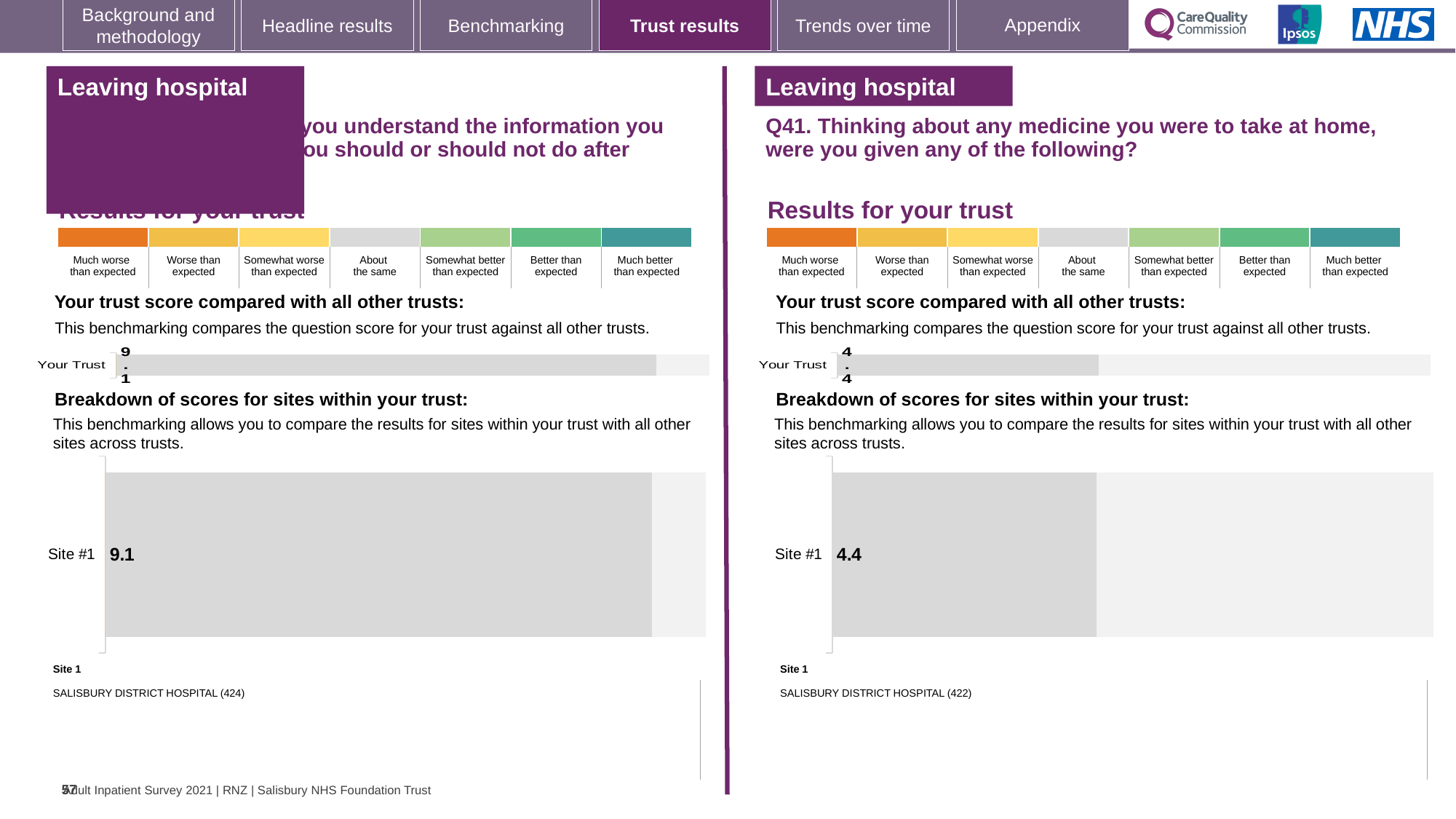
On the right half of the slide (Q41), what is the score shown for Your Trust in the 'Your trust score compared with all other trusts' chart? 4.4 Which Site #1 score is larger: the one in the left breakdown chart or the one in the right (Q41) breakdown chart? The left chart (9.1) What is the difference between the Site #1 score in the left breakdown chart and the Site #1 score in the right (Q41) breakdown chart? 4.7 On the right half of the slide (Q41), which hospital is listed as Site 1 below the breakdown chart? SALISBURY DISTRICT HOSPITAL (422) In the left breakdown chart, is the Site #1 score the same as the Your Trust score shown above it? Yes In the right 'Breakdown of scores for sites within your trust' chart (Q41), what is the score for Site #1? 4.4 What kind of chart is used for the 'Breakdown of scores for sites within your trust' on the right half of the slide? Bar chart In the left 'Breakdown of scores for sites within your trust' chart, what is the score for Site #1? 9.1 How many sites are shown in the left 'Breakdown of scores for sites within your trust' chart? 1 On the left half of the slide, what is the score shown for Your Trust in the 'Your trust score compared with all other trusts' chart? 9.1 On the left half of the slide, which hospital is listed as Site 1 below the breakdown chart? SALISBURY DISTRICT HOSPITAL (424)